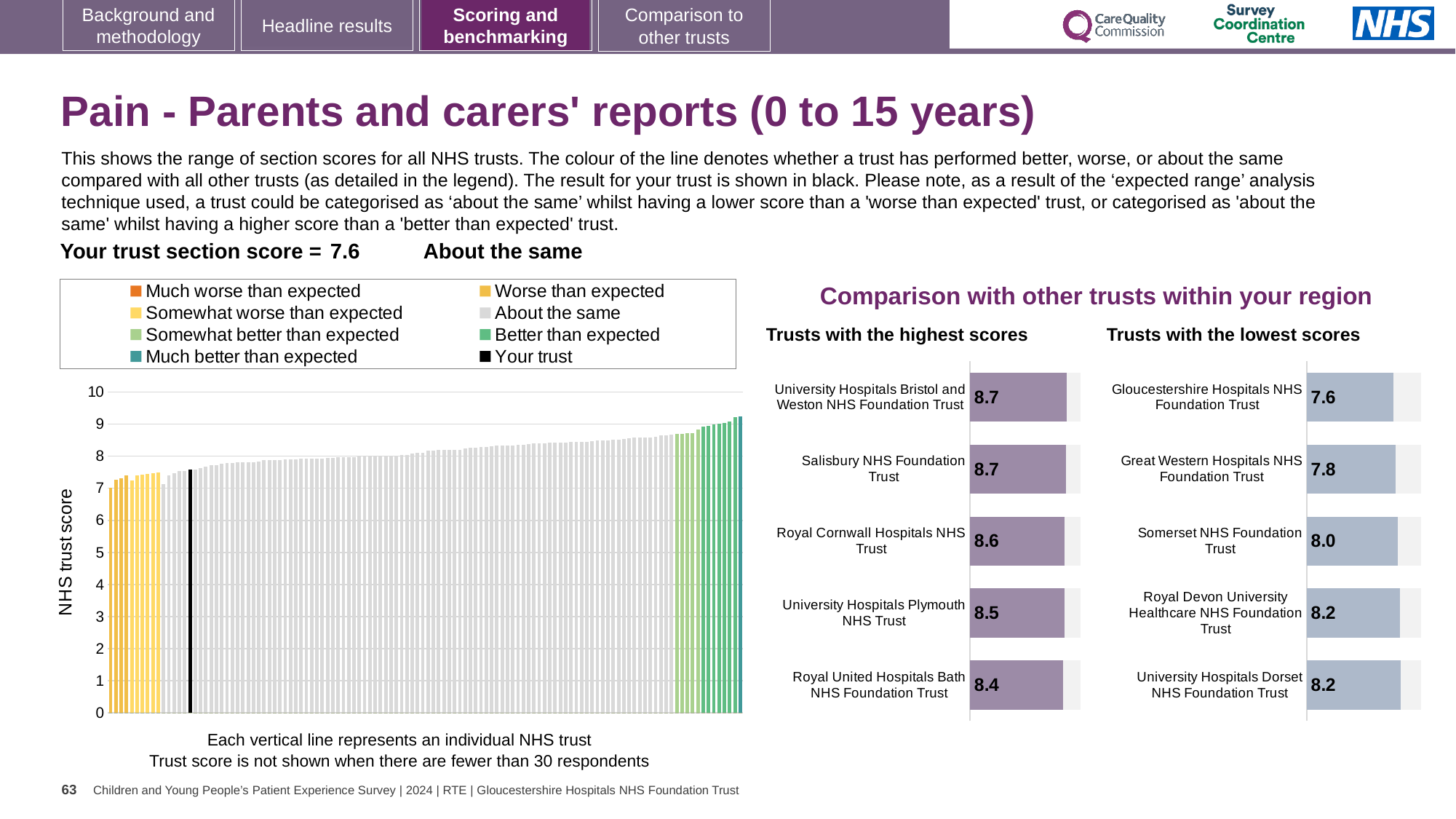
In the 'Trusts with the highest scores' chart, what is the difference between the scores of Salisbury NHS Foundation Trust and Royal United Hospitals Bath NHS Foundation Trust? 0.3 What kind of chart is the large chart on the left of the slide? bar chart In the chart on the left, is the value of the rightmost bar greater or less than 9? greater In the chart on the left, do the bar heights rise or fall from left to right? rise How many entries does the legend above the chart on the left list? 8 In the 'Trusts with the lowest scores' chart, which trust has the lowest score? Gloucestershire Hospitals NHS Foundation Trust In the chart on the left, is the value of the black bar (your trust) greater or less than 8? less In the chart on the left, what is the label on the vertical axis? NHS trust score In the 'Trusts with the lowest scores' chart, what is the score for Great Western Hospitals NHS Foundation Trust? 7.8 In the 'Trusts with the highest scores' chart, which trust has the lowest score? Royal United Hospitals Bath NHS Foundation Trust In the 'Trusts with the highest scores' chart, what is the score for Royal Cornwall Hospitals NHS Trust? 8.6 In the 'Trusts with the lowest scores' chart, which has the higher score: Great Western Hospitals NHS Foundation Trust or Somerset NHS Foundation Trust? Somerset NHS Foundation Trust